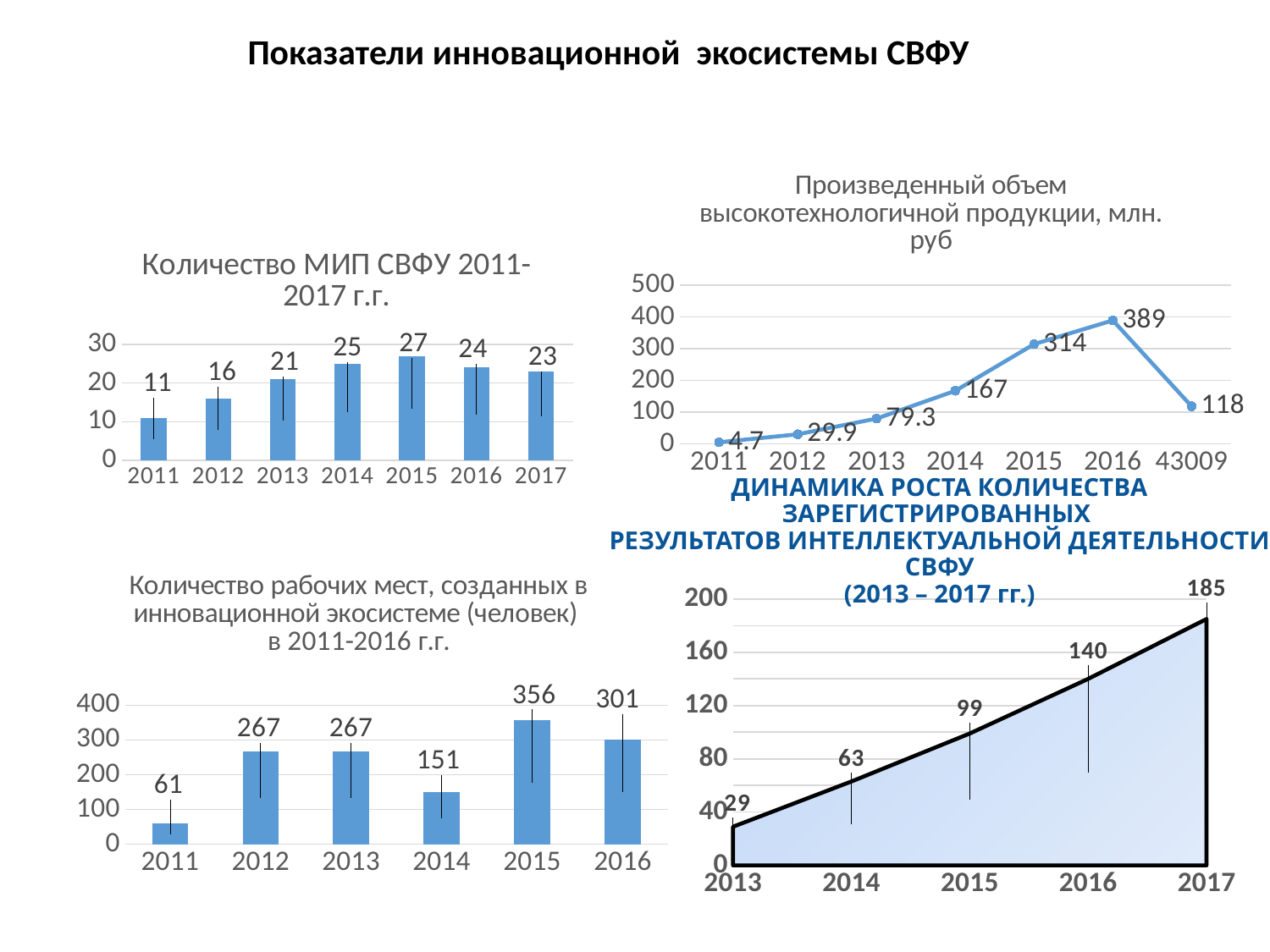
In the chart 'Количество МИП СВФУ 2011-2017 г.г.', what is the value for 2015? 27 In the bottom-right chart 'ДИНАМИКА РОСТА КОЛИЧЕСТВА ЗАРЕГИСТРИРОВАННЫХ РЕЗУЛЬТАТОВ ИНТЕЛЛЕКТУАЛЬНОЙ ДЕЯТЕЛЬНОСТИ СВФУ', what is the value for 2016? 140 In the chart 'Произведенный объем высокотехнологичной продукции, млн. руб', what is the difference between the values for 2016 and 2015? 75 What kind of chart is 'Произведенный объем высокотехнологичной продукции, млн. руб'? line chart In the chart 'Количество рабочих мест, созданных в инновационной экосистеме (человек) в 2011-2016 г.г.', what is the value for 2014? 151 In the chart 'Произведенный объем высокотехнологичной продукции, млн. руб', which year has the highest value? 2016 In the chart 'Количество МИП СВФУ 2011-2017 г.г.', how many years are plotted? 7 In the chart 'Произведенный объем высокотехнологичной продукции, млн. руб', what is the value for 2014? 167 In the bottom-right chart 'ДИНАМИКА РОСТА КОЛИЧЕСТВА ЗАРЕГИСТРИРОВАННЫХ РЕЗУЛЬТАТОВ ИНТЕЛЛЕКТУАЛЬНОЙ ДЕЯТЕЛЬНОСТИ СВФУ', do the values rise or fall from 2013 to 2017? rise In the chart 'Количество МИП СВФУ 2011-2017 г.г.', which year has the lowest value? 2011 In the chart 'Количество рабочих мест, созданных в инновационной экосистеме (человек) в 2011-2016 г.г.', which is larger, the value for 2015 or 2016? 2015 In the chart 'Количество рабочих мест, созданных в инновационной экосистеме (человек) в 2011-2016 г.г.', which year has the highest value? 2015